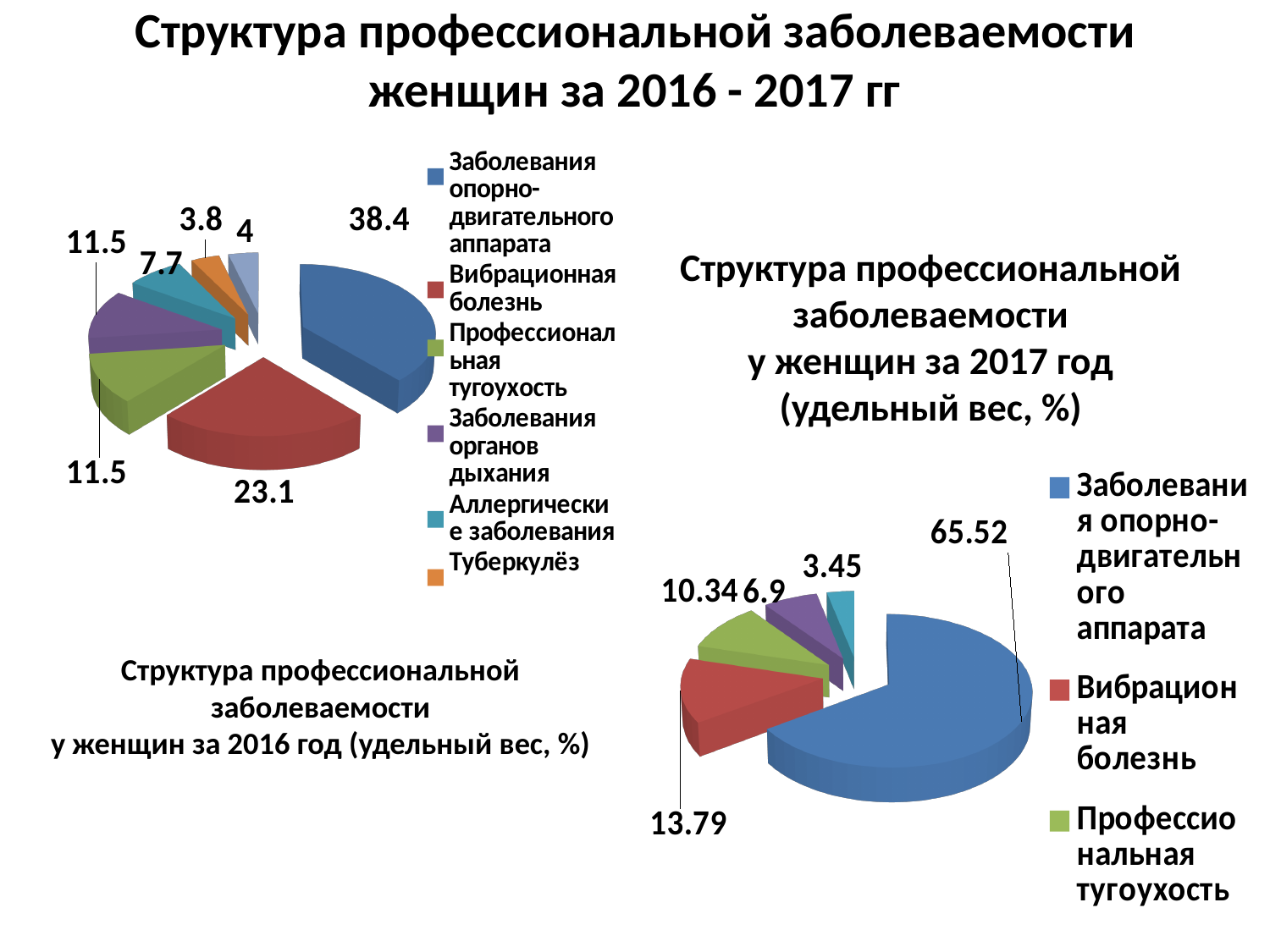
In the 2016 chart (left), what is the value for Аллергические заболевания? 7.7 In the 2016 chart (left), what is the value for Вибрационная болезнь? 23.1 In the 2016 chart (left), what is the difference between Заболевания опорно-двигательного аппарата and Вибрационная болезнь? 15.3 How many slices does the 2017 chart (right) have? 5 In the 2016 chart (left), which category has the largest share? Заболевания опорно-двигательного аппарата In the 2016 chart (left), what is the value for Заболевания опорно-двигательного аппарата? 38.4 In the 2017 chart (right), what is the value for Профессиональная тугоухость? 10.34 In the 2017 chart (right), what is the value for Вибрационная болезнь? 13.79 In the 2017 chart (right), which is larger: Вибрационная болезнь or Профессиональная тугоухость? Вибрационная болезнь In the 2016 chart (left), what is the value for Туберкулёз? 3.8 In the 2017 chart (right), what is the value for Заболевания опорно-двигательного аппарата? 65.52 What type of chart is the left chart (2016)? pie chart